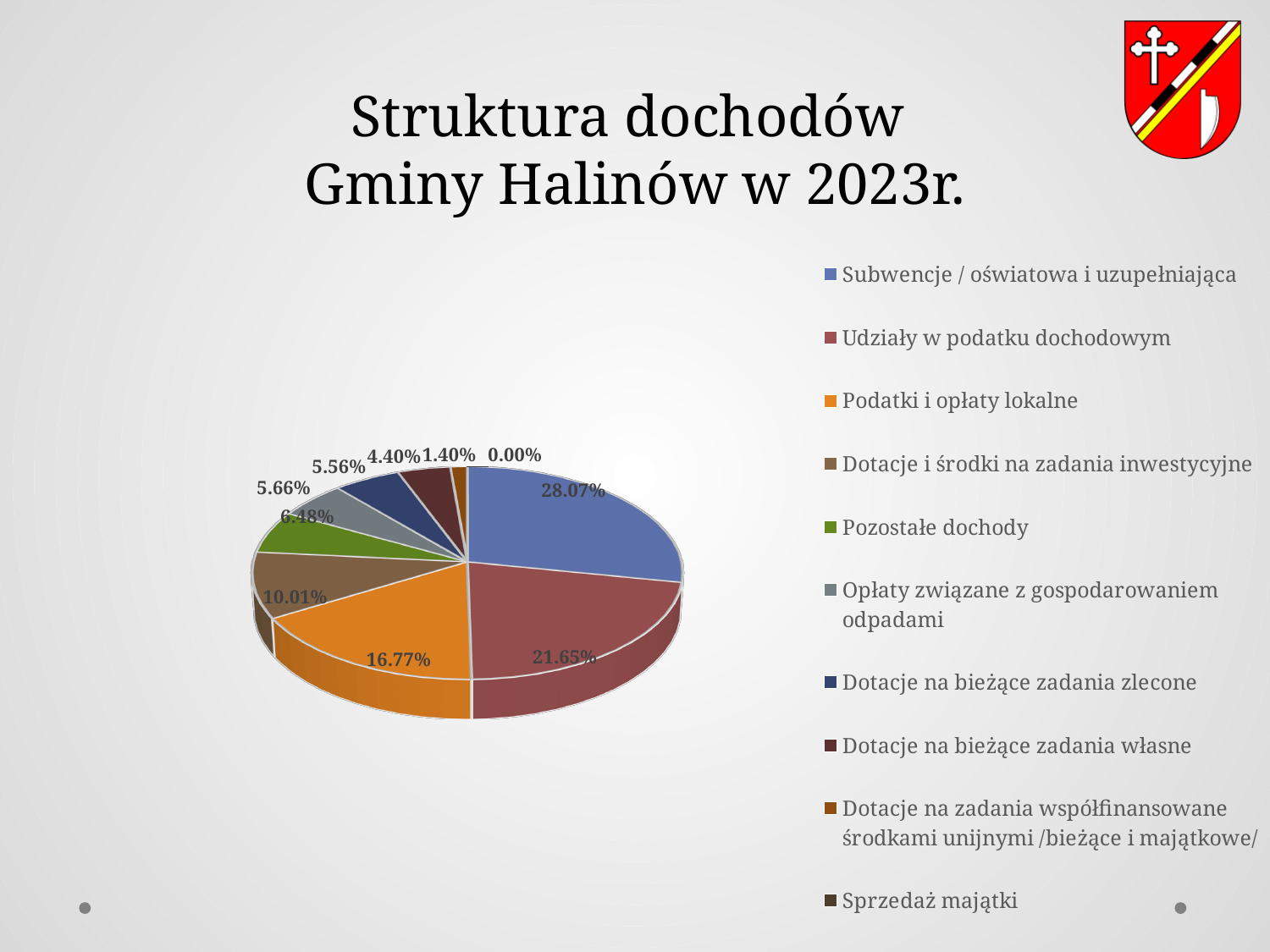
What is the value shown for "Podatki i opłaty lokalne"? 16.77% What is the value shown for "Udziały w podatku dochodowym"? 21.65% What is the title of the slide containing the chart? Struktura dochodów Gminy Halinów w 2023r. What share of the pie does "Subwencje / oświatowa i uzupełniająca" have? 28.07% What is the difference between the shares of "Subwencje / oświatowa i uzupełniająca" and "Udziały w podatku dochodowym"? 6.42% How many categories does the legend list? 10 What kind of chart is shown on the slide? pie chart Which is larger: the share for "Podatki i opłaty lokalne" or for "Dotacje i środki na zadania inwestycyjne"? Podatki i opłaty lokalne What is the value shown for "Dotacje i środki na zadania inwestycyjne"? 10.01% Which category has the largest share of the pie? Subwencje / oświatowa i uzupełniająca Which category has the smallest share of the pie? Sprzedaż majątki What is the value shown for "Pozostałe dochody"? 6.48%